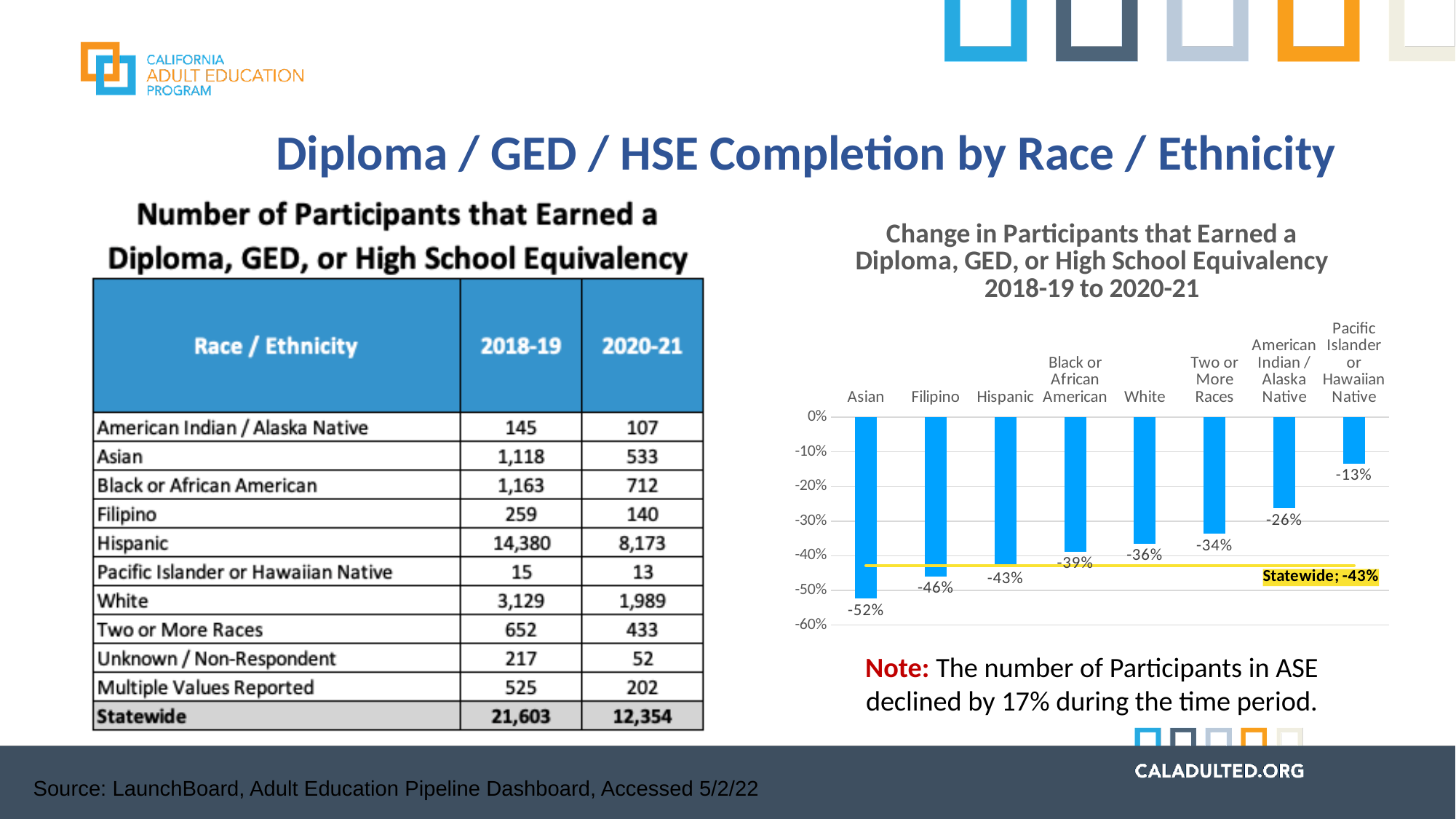
What is the change in participants for Hispanic shown in the chart? -43% Which race/ethnicity group shows the largest decline in the chart? Asian What is the change in participants for Asian shown in the chart? -52% Do the bar values become less negative or more negative moving from left to right along the x axis? Less negative Which race/ethnicity group shows the smallest decline in the chart? Pacific Islander or Hawaiian Native How many race/ethnicity groups are plotted as bars in the chart? 8 What is the change in participants for White shown in the chart? -36% What statewide change value is marked by the horizontal line in the chart? -43% What is the change in participants for Pacific Islander or Hawaiian Native shown in the chart? -13% Which group had a larger decline, Black or African American or American Indian / Alaska Native? Black or African American What is the difference in percentage points between the change for Filipino and the change for Two or More Races? 12 percentage points What kind of chart is shown on the slide? Bar chart